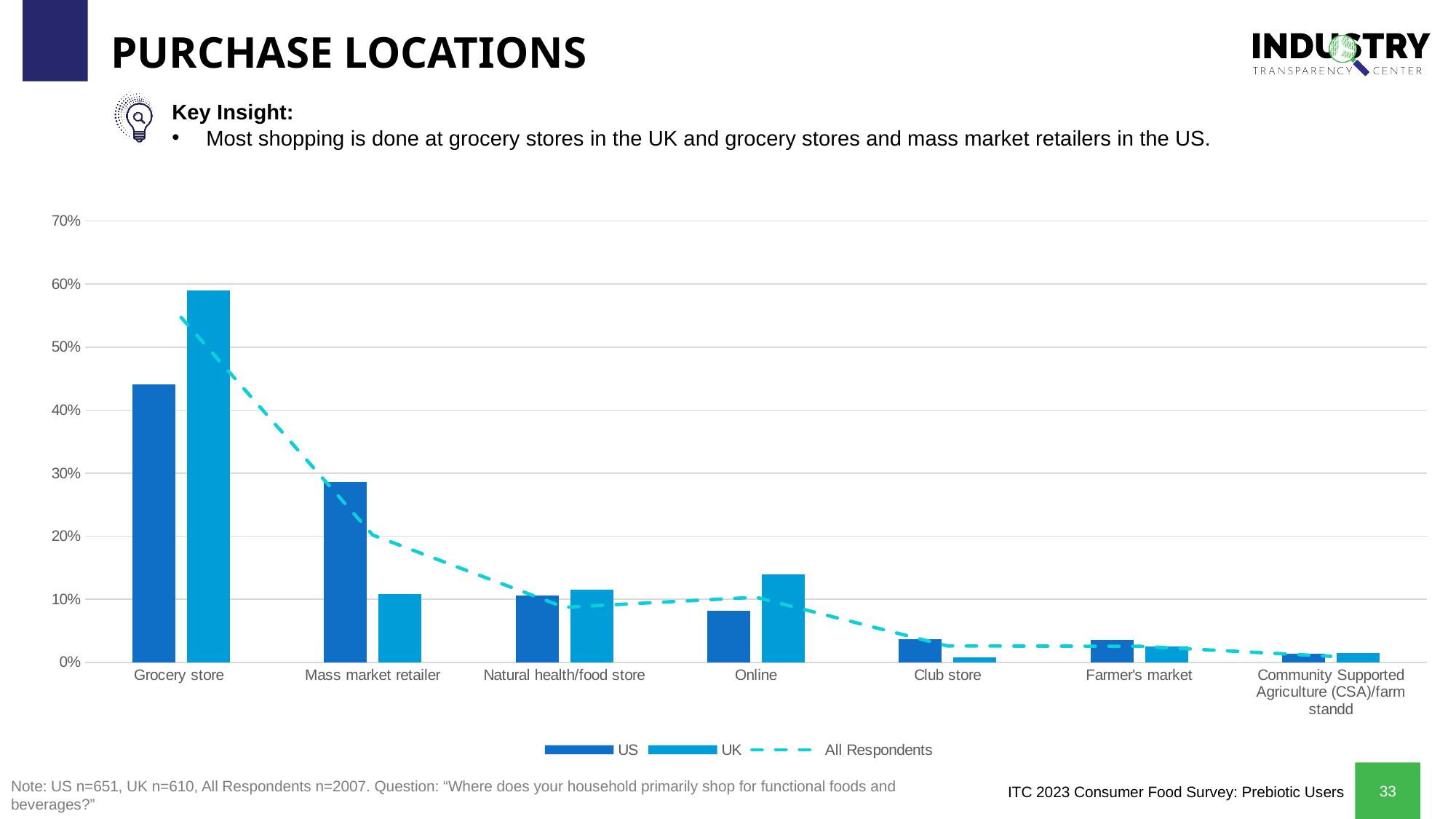
Is the US value for Mass market retailer greater or less than 20%? greater Which category has the highest UK value? Grocery store How many series does the legend list? 3 Is the UK value for Grocery store greater or less than 50%? greater Is the UK value for Online greater or less than 10%? greater How many purchase location categories are shown on the x axis? 7 What kind of chart is shown on the slide? combination bar and line chart For Mass market retailer, which is larger, the US value or the UK value? US For Online, which is larger, the US value or the UK value? UK Which category has the lowest UK value? Club store Which category has the highest US value? Grocery store Which series is shown as a dashed line? All Respondents